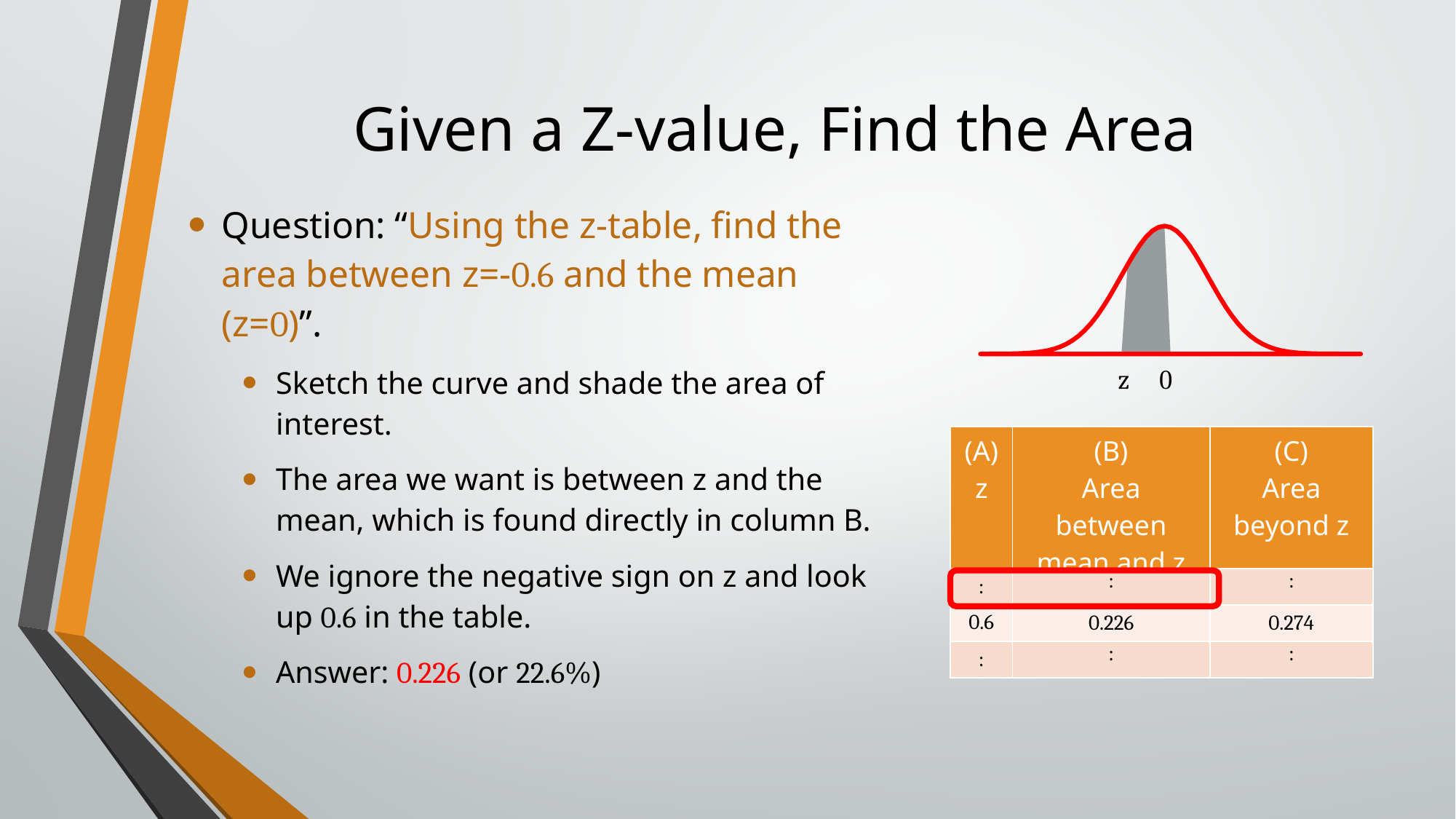
In the table, for z = 0.6, which is larger: the area between mean and z or the area beyond z? Area beyond z In the curve diagram, what two labels appear below the horizontal axis? z and 0 What is the heading of column (C) in the table? Area beyond z In the table, what is the value in column (B), Area between mean and z, for z = 0.6? 0.226 Which row of the table is outlined with a red box? The row above 0.6 (the row of dots) How many labelled columns does the table have? 3 In the table, what is the difference between the area beyond z and the area between mean and z for z = 0.6? 0.048 In the table, what is the value in column (C), Area beyond z, for z = 0.6? 0.274 In the table, what is the sum of the area between mean and z and the area beyond z for z = 0.6? 0.5